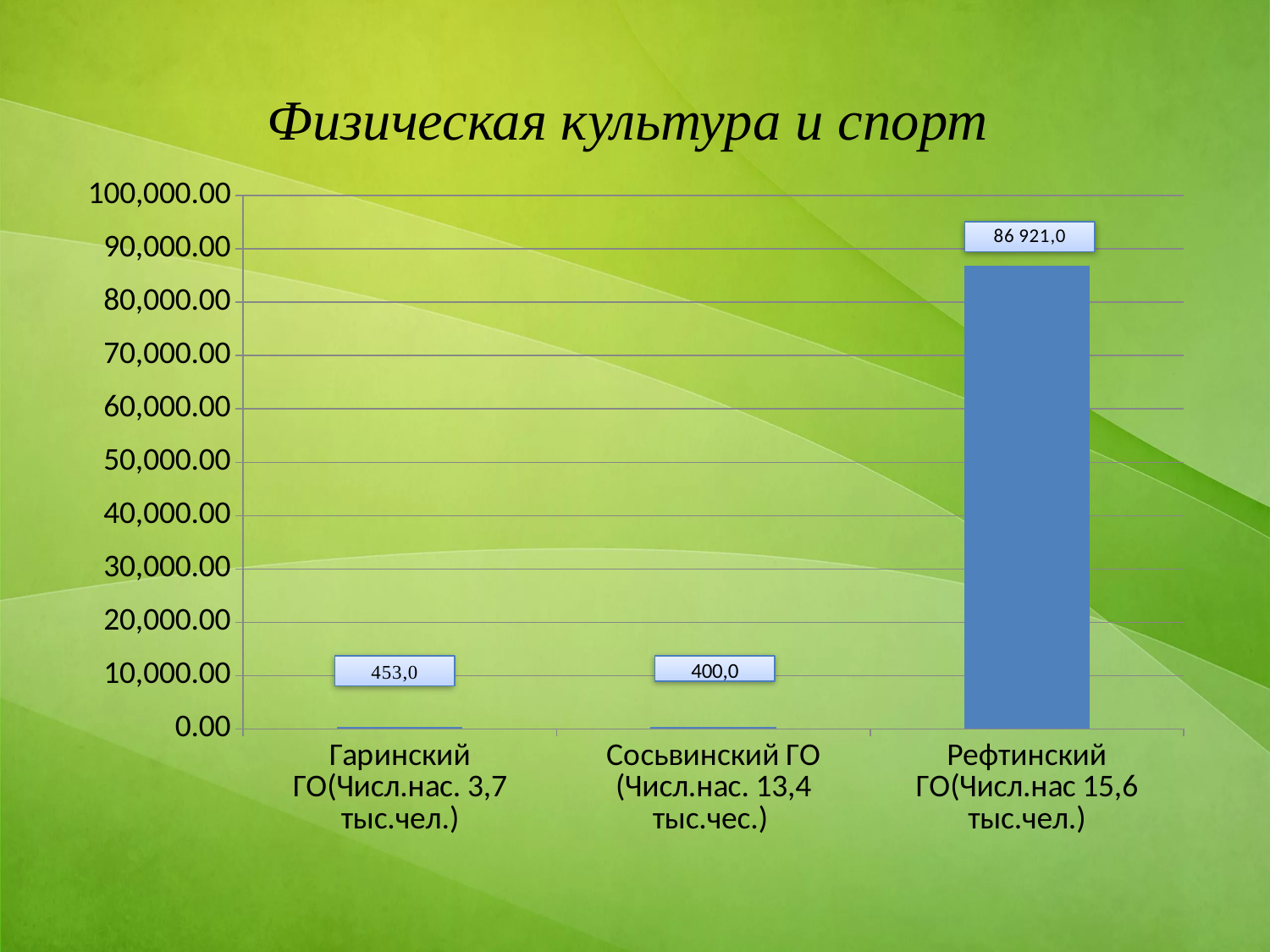
What is the value for Гаринский ГО? 453,0 What is the value for Сосьвинский ГО? 400,0 What is the difference between the values for Гаринский ГО and Сосьвинский ГО? 53,0 Is the value for Гаринский ГО greater or less than 10,000.00? less What is the value for Рефтинский ГО? 86 921,0 What kind of chart is shown on the slide? bar chart Which category has the highest value? Рефтинский ГО Is the value for Рефтинский ГО greater or less than 80,000.00? greater How many categories are shown on the chart? 3 Which is larger, the value for Гаринский ГО or the value for Сосьвинский ГО? Гаринский ГО What is the difference between the values for Рефтинский ГО and Гаринский ГО? 86 468,0 Which category has the lowest value? Сосьвинский ГО